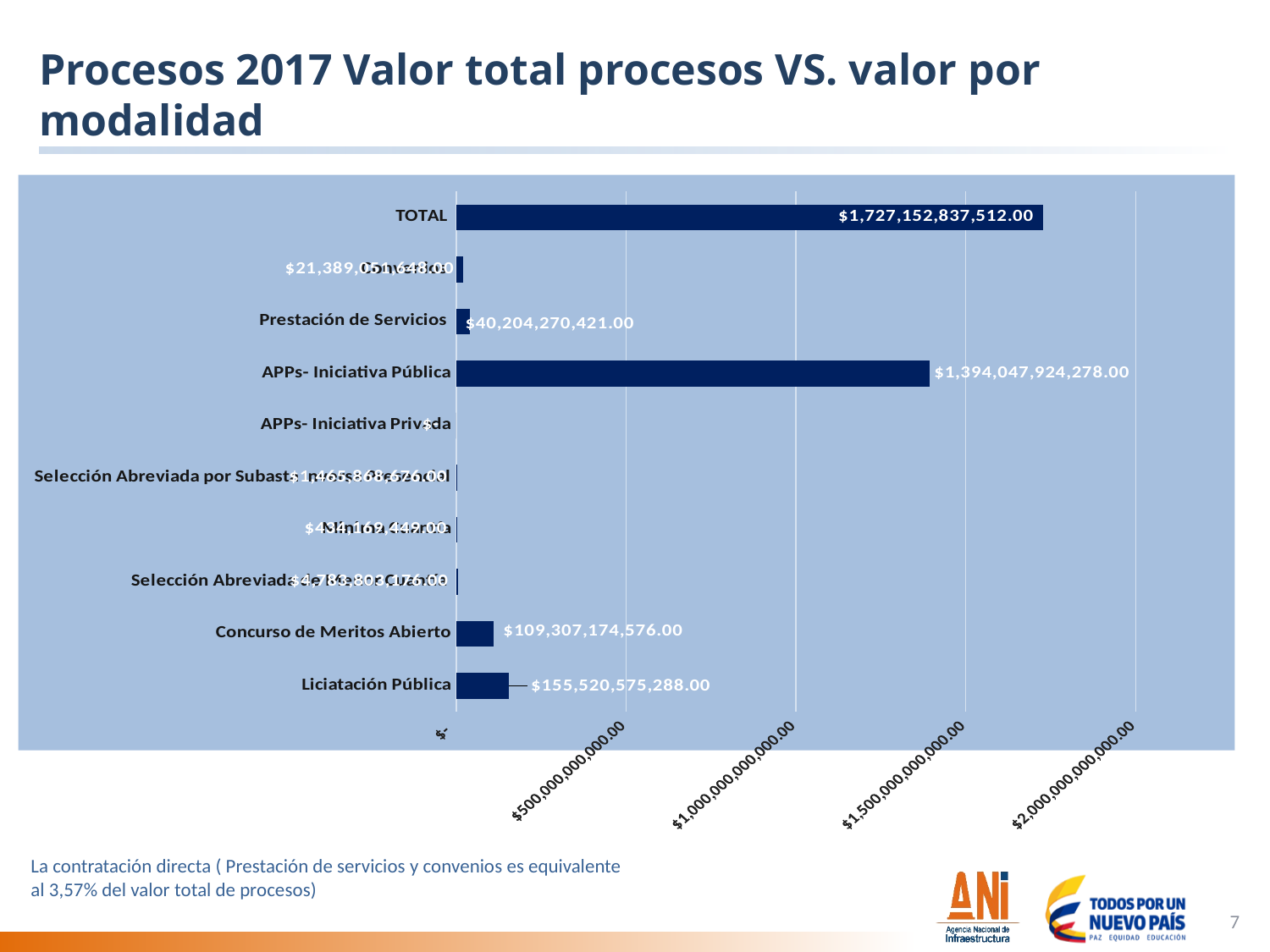
Excluding the TOTAL bar, which modality has the highest value? APPs- Iniciativa Pública What is the value shown for Prestación de Servicios? $40,204,270,421.00 What is the value shown for Licitación Pública? $155,520,575,288.00 What is the value shown for Concurso de Meritos Abierto? $109,307,174,576.00 What is the difference between the TOTAL value and the APPs- Iniciativa Pública value? $333,104,913,234.00 What is the value shown for APPs- Iniciativa Pública? $1,394,047,924,278.00 Is the value for APPs- Iniciativa Pública greater or less than $1,000,000,000,000.00? greater What is the value shown for TOTAL? $1,727,152,837,512.00 How many categories are plotted on the chart, including TOTAL? 10 What kind of chart is shown on the slide? Bar chart Which is larger, Licitación Pública or Concurso de Meritos Abierto? Licitación Pública What is the difference between Licitación Pública and Concurso de Meritos Abierto? $46,213,400,712.00